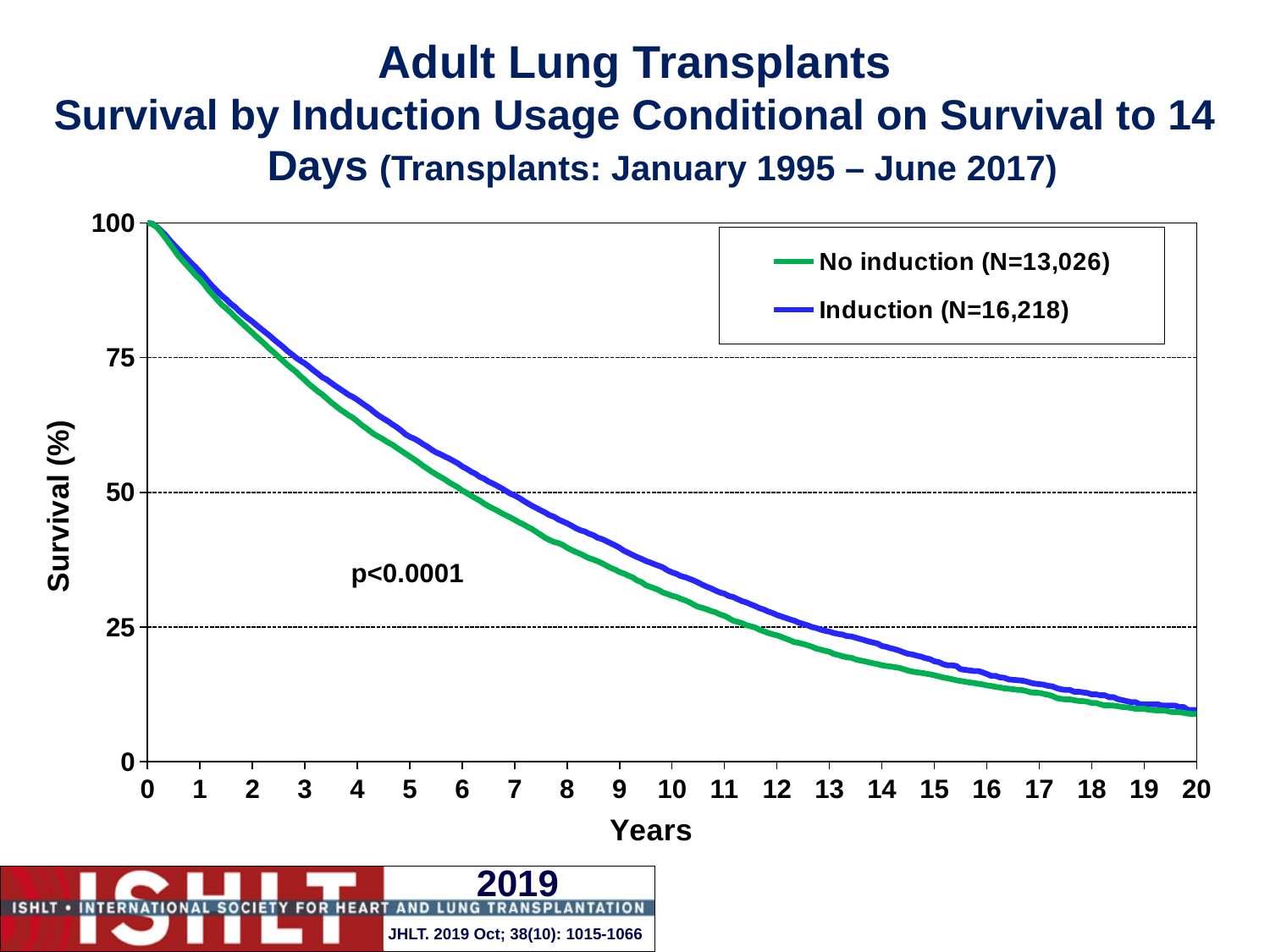
What is the N value shown in the legend for the No induction series? N=13,026 Is the survival value for Induction at year 2 greater or less than 75? greater What p-value is printed on the chart? p<0.0001 Is the survival value for No induction at year 15 greater or less than 25? less What kind of chart is shown on the slide? line chart Is the survival value for No induction at year 8 greater or less than 50? less At year 10, which series has the higher survival, No induction or Induction? Induction How many series does the legend list? 2 Do the survival curves rise or fall as years increase along the x axis? fall How many year tick marks are labelled on the x axis? 21 What is the survival value for the Induction series at year 0? 100